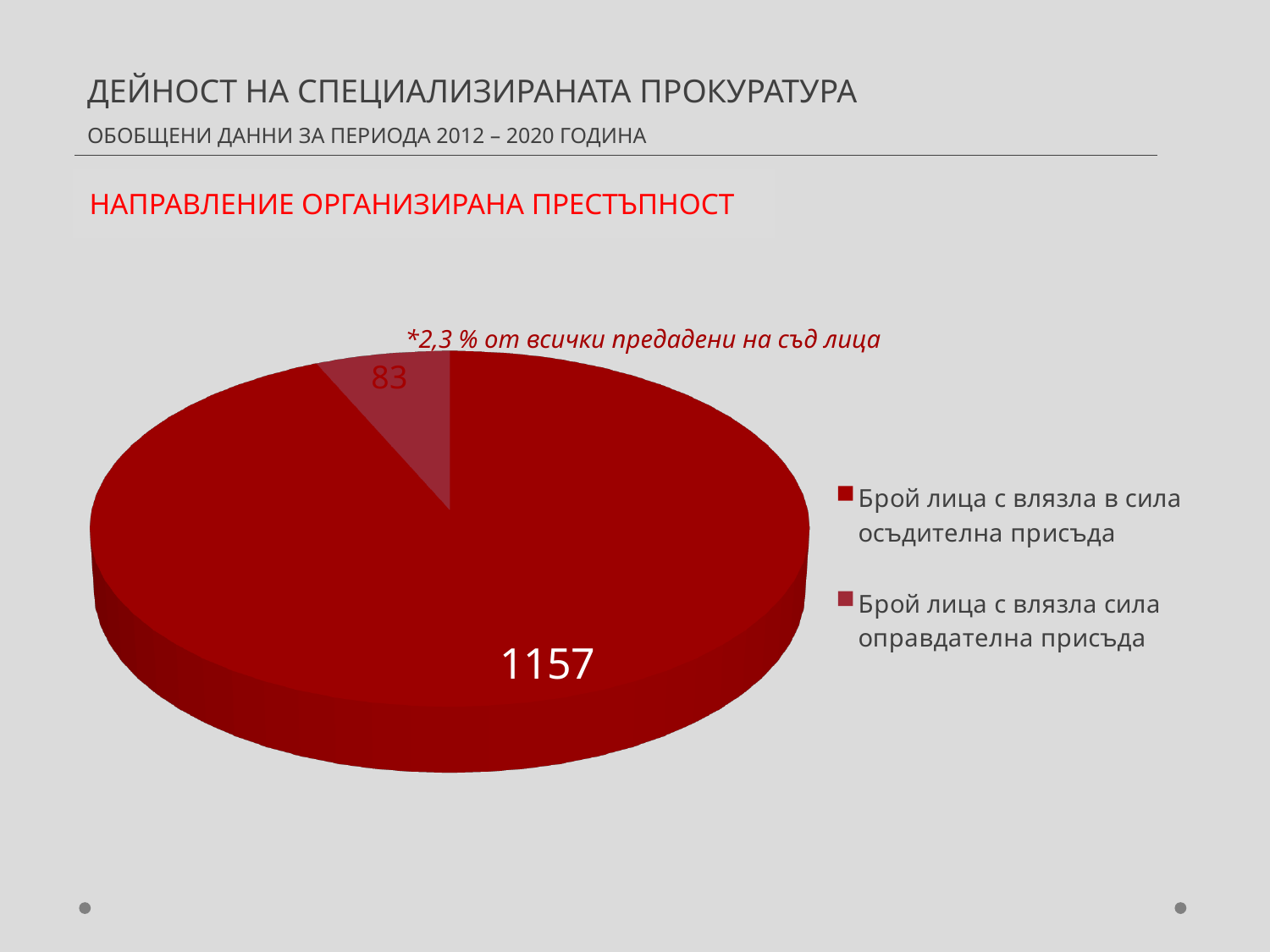
Which category has the smallest slice of the pie? Брой лица с влязла сила оправдателна присъда What type of chart is shown on the slide? Pie chart What share of the pie does the slice with value 83 represent, to one decimal place? 6.7% What note in italics is printed above the pie chart? *2,3 % от всички предадени на съд лица How many slices does the pie chart have? 2 What is the value for "Брой лица с влязла сила оправдателна присъда"? 83 What is the total of the two values shown in the pie chart? 1240 How many entries does the legend list? 2 Which category has the largest slice of the pie? Брой лица с влязла в сила осъдителна присъда What is the value for "Брой лица с влязла в сила осъдителна присъда"? 1157 Which is larger: the number of persons with a conviction in force or the number with an acquittal in force? Брой лица с влязла в сила осъдителна присъда What is the difference between the number of persons with a conviction in force (1157) and the number with an acquittal in force (83)? 1074